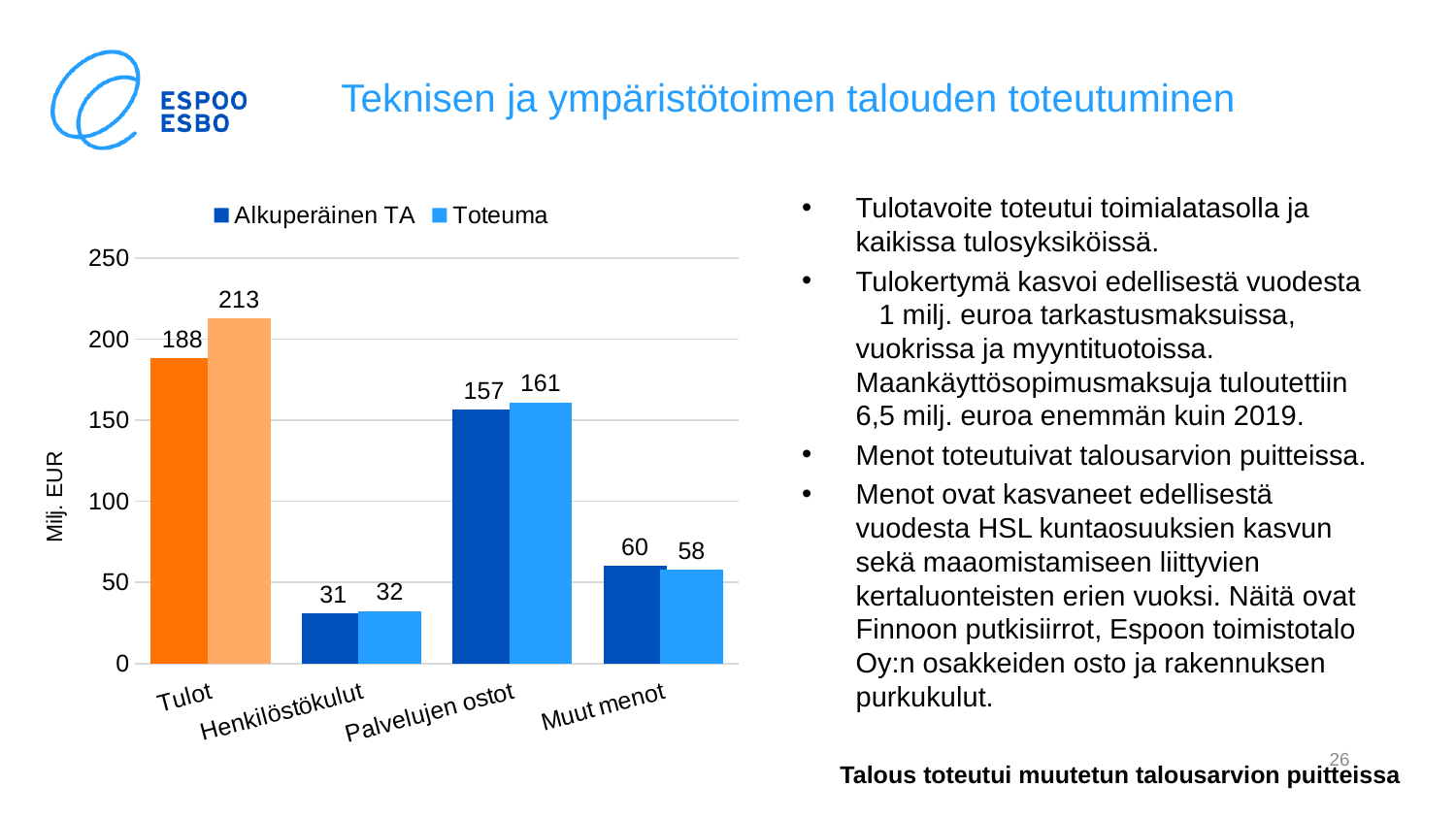
How many series does the legend list? 2 Which category has the highest Toteuma value? Tulot Which category has the lowest Alkuperäinen TA value? Henkilöstökulut What is the difference between the Toteuma and Alkuperäinen TA values for Tulot? 25 What is the Toteuma value for Tulot? 213 What is the label of the y axis? Milj. EUR For Muut menot, which is larger: Alkuperäinen TA or Toteuma? Alkuperäinen TA What kind of chart is shown on the slide? bar chart How many categories are shown on the x axis? 4 What is the Alkuperäinen TA value for Palvelujen ostot? 157 Is the Toteuma value for Palvelujen ostot greater or less than 150? greater What is the Toteuma value for Muut menot? 58